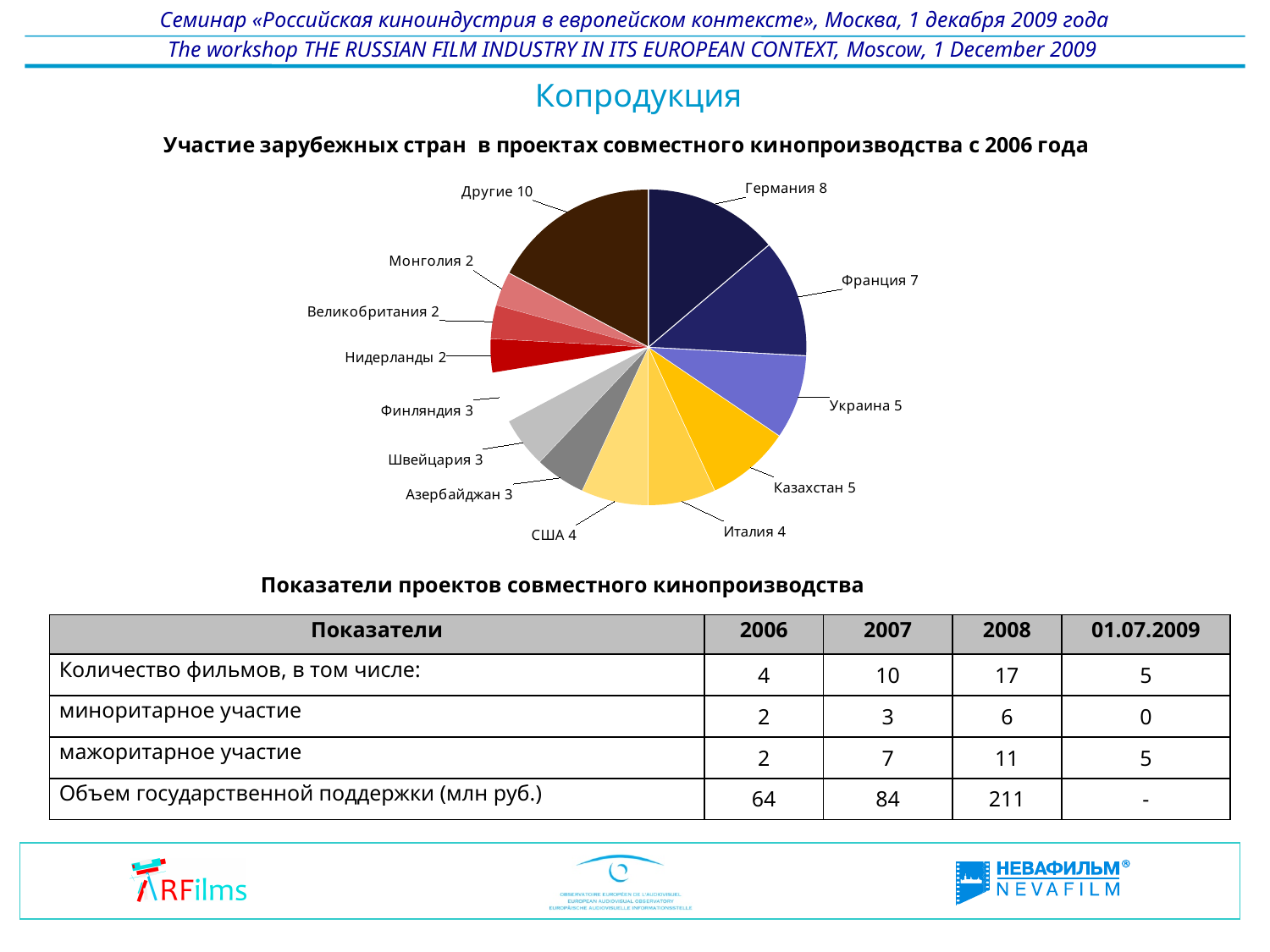
What is the title of the pie chart? Участие зарубежных стран в проектах совместного кинопроизводства с 2006 года Which has a larger value in the pie chart, Казахстан or Швейцария? Казахстан What is the value shown for Германия in the pie chart? 8 How many slices does the pie chart have? 13 What kind of chart is shown on the slide? Pie chart What is the difference between the values for Германия and Франция? 1 What is the value shown for Азербайджан in the pie chart? 3 What is the difference between the values for Другие and Италия? 6 What is the value shown for Нидерланды in the pie chart? 2 Which slice of the pie chart has the largest value? Другие What is the value shown for Украина in the pie chart? 5 Which named country has the largest value in the pie chart? Германия